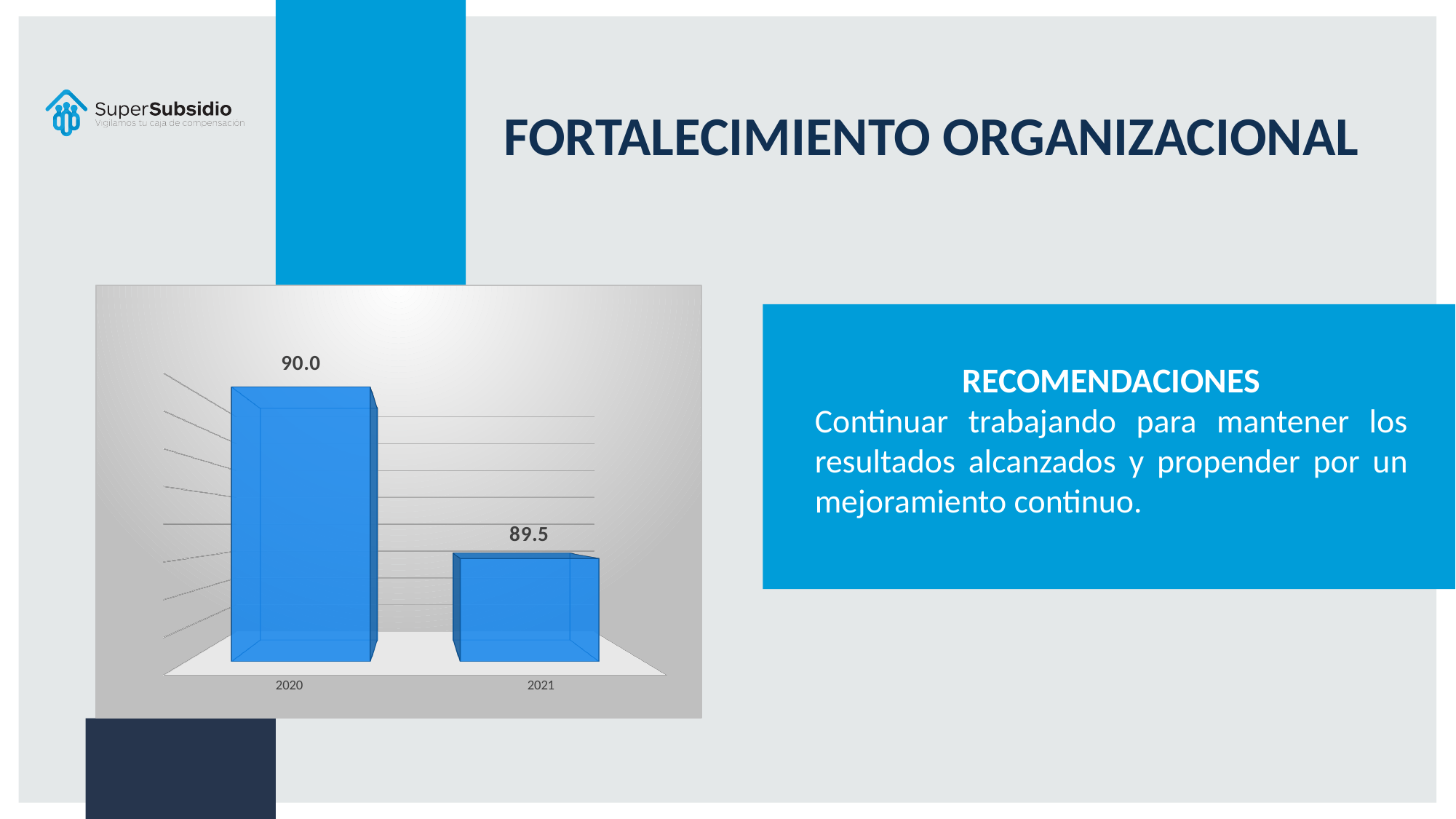
How many categories are shown on the x axis? 2 What is the value for 2021? 89.5 What is the title of the slide containing the chart? FORTALECIMIENTO ORGANIZACIONAL Do the values rise or fall from 2020 to 2021? fall Which year has the lowest value? 2021 Which year has the highest value? 2020 What is the difference between the values for 2020 and 2021? 0.5 What colour are the bars in the chart? blue What kind of chart is shown on the slide? bar chart What is the value for 2020? 90.0 Which is larger, the value for 2020 or the value for 2021? 2020